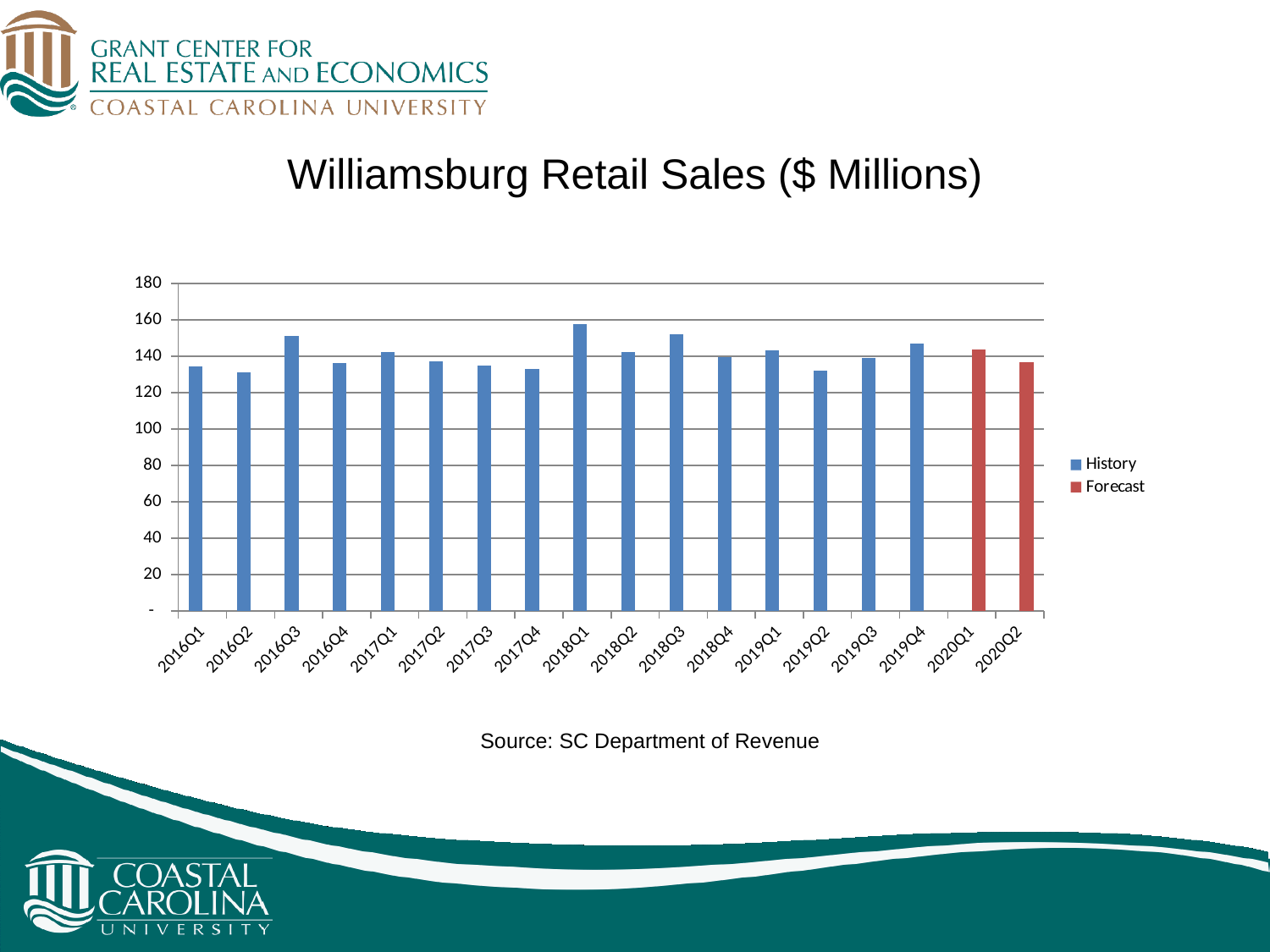
Which is larger, the value for 2018Q1 or the value for 2016Q2? 2018Q1 What is the title of the chart? Williamsburg Retail Sales ($ Millions) Is the value for 2018Q1 greater or less than 140? greater What kind of chart is shown on the slide? bar chart Which quarter has the highest retail sales? 2018Q1 Is the value for 2017Q4 greater or less than 140? less Which is larger, the value for 2016Q3 or the value for 2016Q4? 2016Q3 Which quarters are shown as Forecast (red bars)? 2020Q1 and 2020Q2 How many quarters are plotted on the x axis? 18 How many series does the legend list? 2 Is the value for 2016Q2 greater or less than 140? less